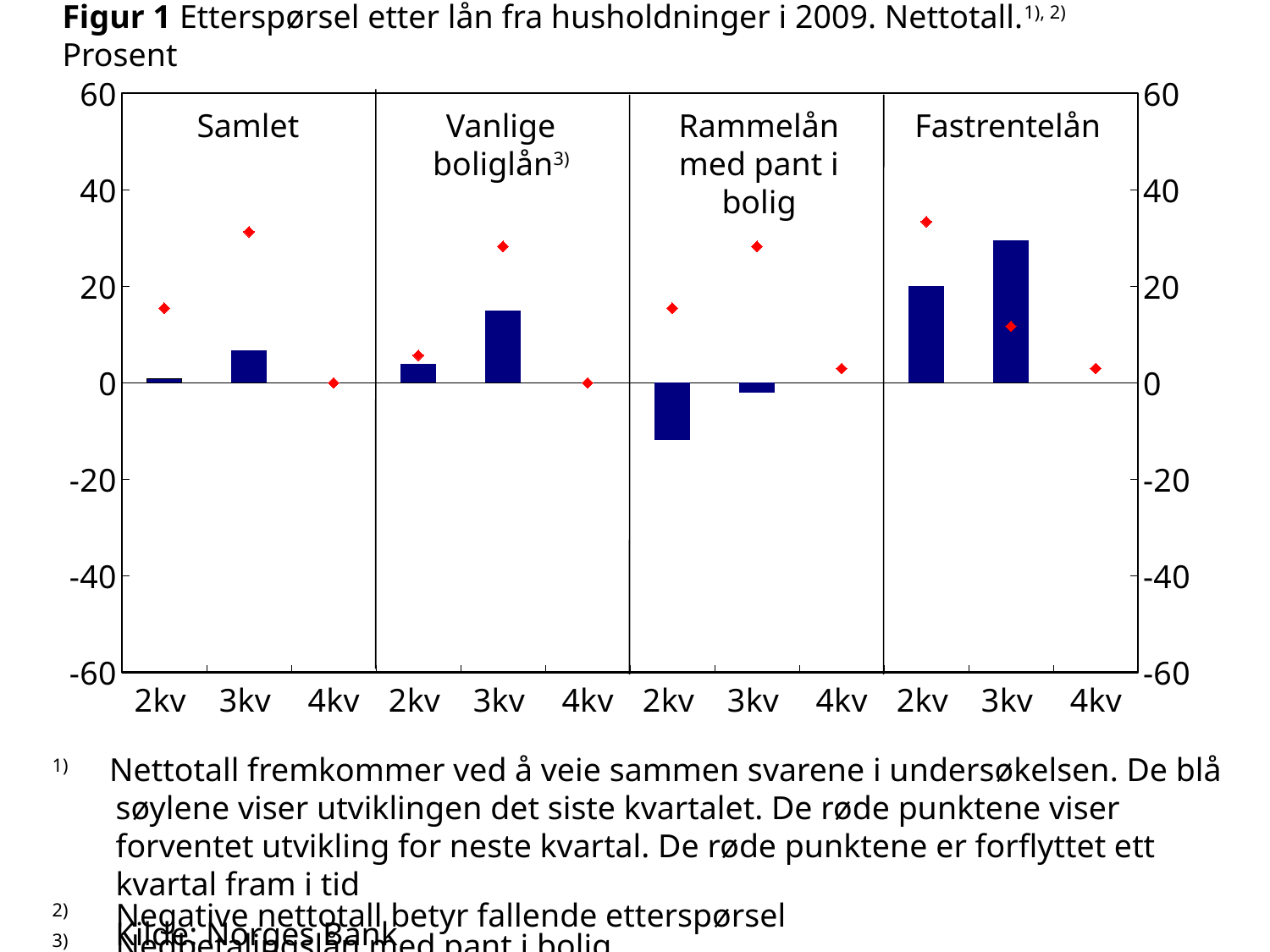
Is the bar value for Fastrentelån in 3kv greater or less than 20? greater Is the red point for Samlet in 3kv greater or less than 20? greater According to the footnote, what do the red points show? Forventet utvikling for neste kvartal How many quarters are shown on the x axis within each panel? 3 What kind of chart is shown in Figur 1? Bar chart (with red point markers) Which panel contains the lowest (most negative) blue bar? Rammelån med pant i bolig Which is larger: the 3kv bar for Samlet or the 3kv bar for Vanlige boliglån? Vanlige boliglån Is the bar value for Vanlige boliglån in 3kv greater or less than 20? less Which panel contains the tallest blue bar? Fastrentelån Do the blue bars for Fastrentelån rise or fall from 2kv to 3kv? rise How many loan categories (panels) does the chart show? 4